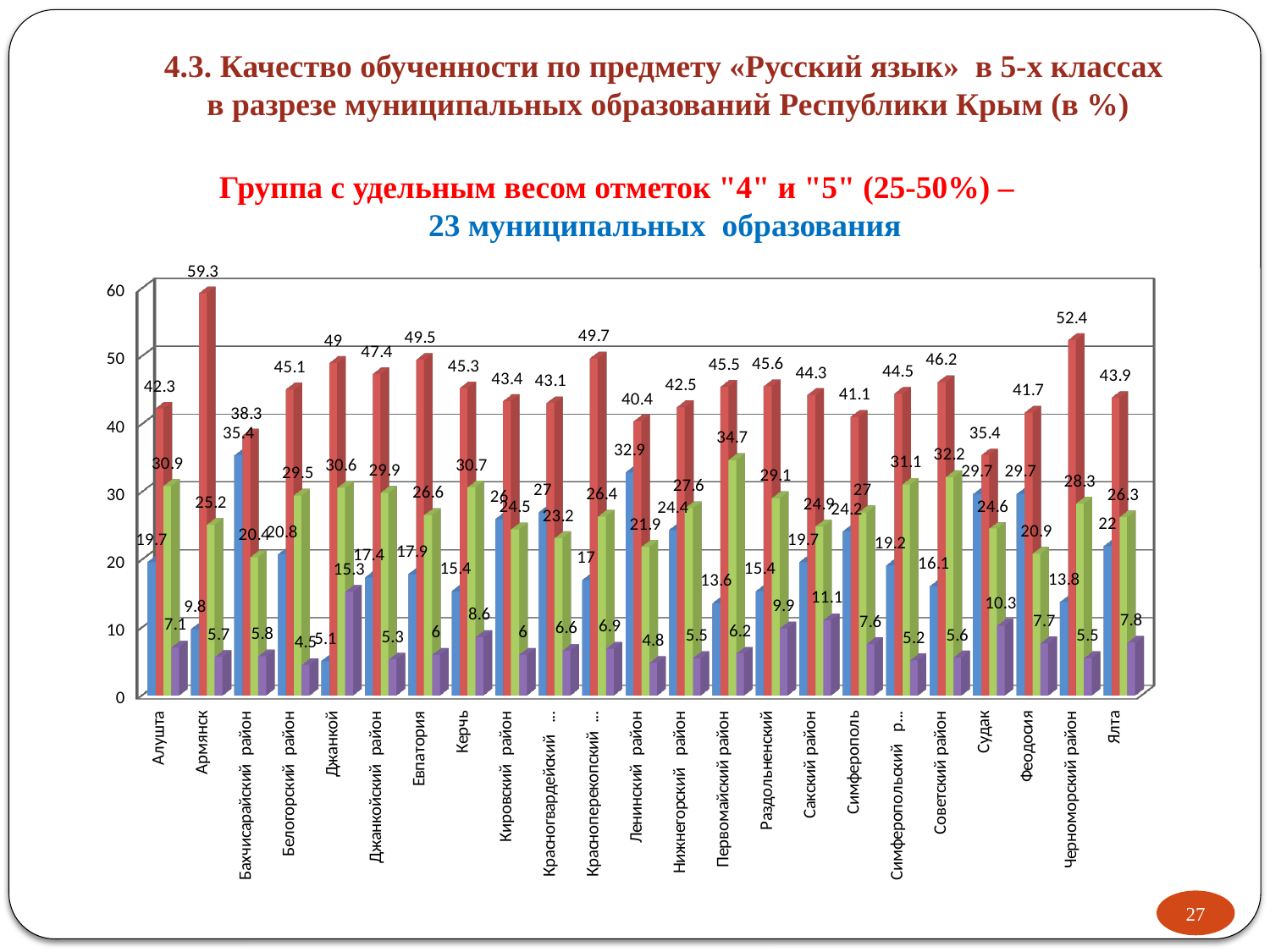
What is the value of the red bar for Керчь? 45.3 How many municipalities (categories) are shown on the x axis of the chart? 23 Is the red bar for Черноморский район greater or less than 50? greater What is the value of the purple bar for Сакский район? 11.1 Which municipality has the lowest blue bar? Джанкой Which is larger: the blue bar for Бахчисарайский район or the blue bar for Ленинский район? Бахчисарайский район How many bars are plotted for each municipality in the chart? 4 What kind of chart is shown on the slide? bar chart Which municipality has the highest purple bar? Джанкой What is the difference between the red bar for Армянск and the red bar for Судак? 23.9 Which municipality has the highest red bar? Армянск What is the value of the green bar for Первомайский район? 34.7